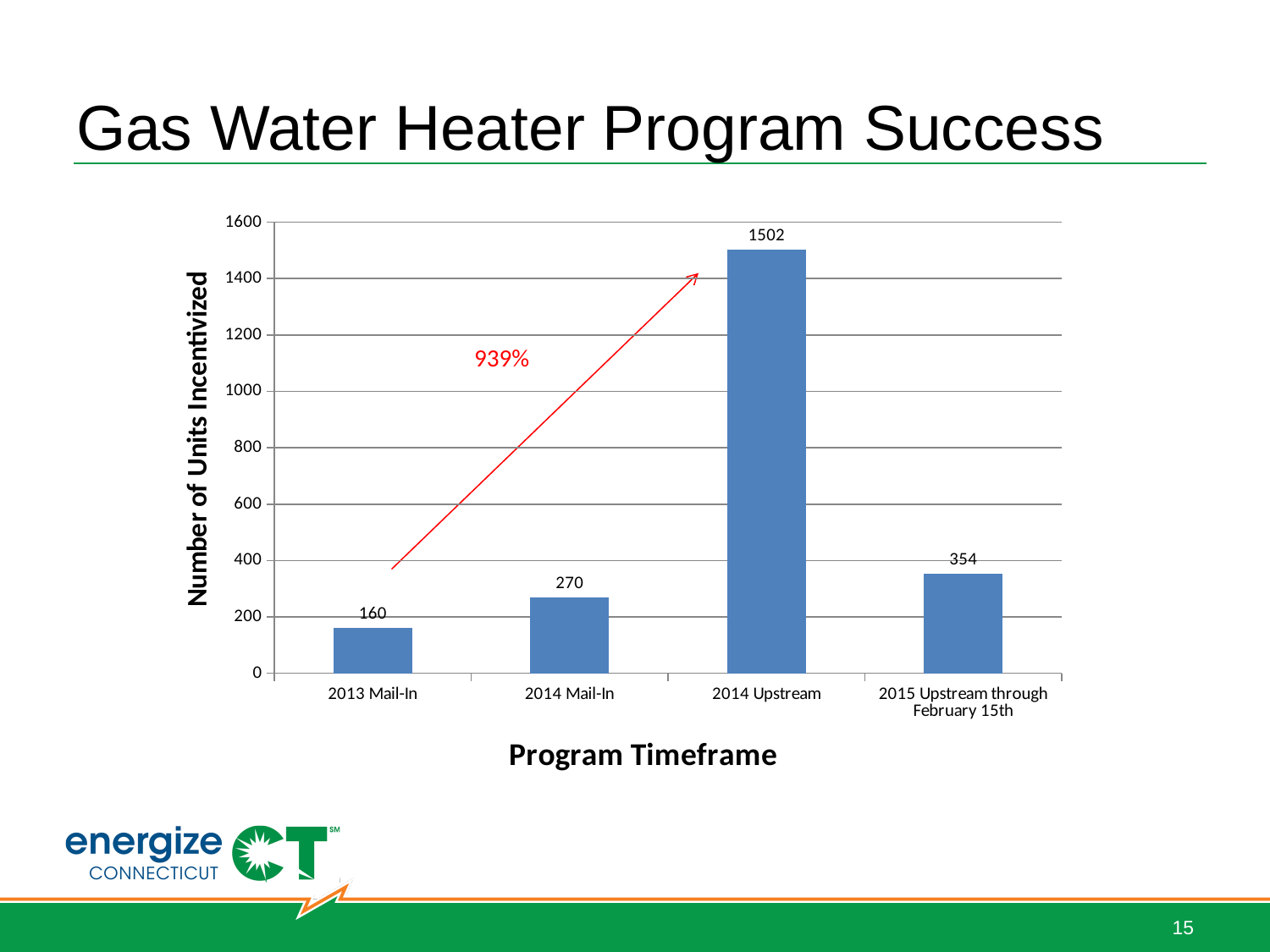
What is the difference between the 2014 Mail-In and 2013 Mail-In values? 110 Which program timeframe has the lowest number of units incentivized? 2013 Mail-In What is the label of the y axis? Number of Units Incentivized What kind of chart is shown on the slide? Bar chart What percentage is written in red next to the arrow on the chart? 939% What is the value for 2014 Upstream? 1502 What is the difference in units incentivized between 2014 Upstream and 2014 Mail-In? 1232 Which program timeframe has the highest number of units incentivized? 2014 Upstream How many units were incentivized in 2015 Upstream through February 15th? 354 Which is larger, the value for 2014 Mail-In or the value for 2015 Upstream through February 15th? 2015 Upstream through February 15th How many units were incentivized in the 2013 Mail-In program? 160 How many program timeframes are shown on the x axis? 4